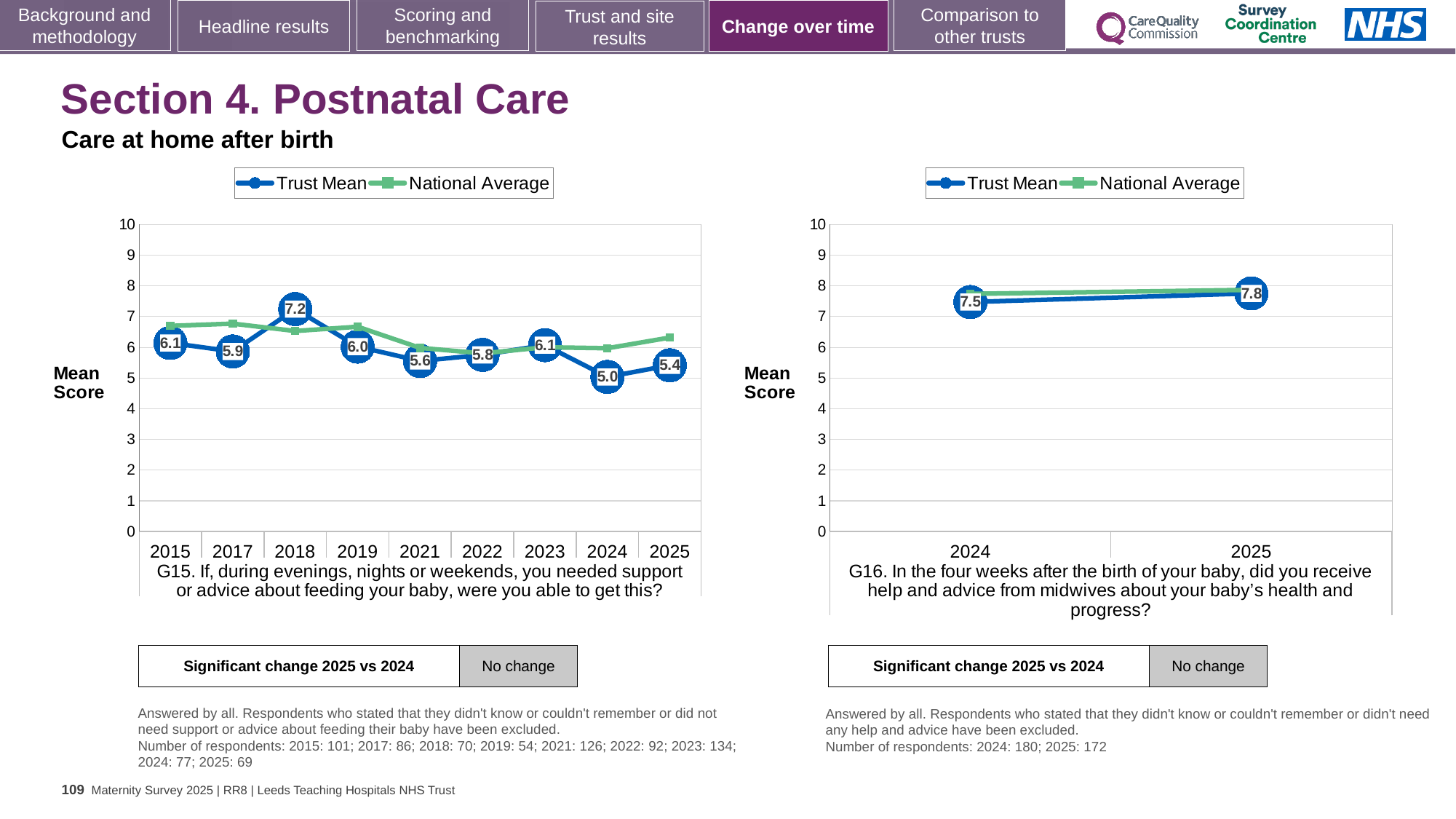
In the G15 chart on the left, which is larger, the Trust Mean for 2023 or the Trust Mean for 2025? 2023 How many years are shown on the x axis of the G15 chart on the left? 9 In the G15 chart on the left, what is the difference between the Trust Mean scores for 2018 and 2024? 2.2 In the G15 chart on the left, what is the Trust Mean score for 2018? 7.2 In the G15 chart on the left, what is the Trust Mean score for 2024? 5.0 In the G15 chart on the left, which year has the lowest Trust Mean score? 2024 In the G16 chart on the right, what is the difference between the Trust Mean scores for 2025 and 2024? 0.3 In the G15 chart on the left, which year has the highest Trust Mean score? 2018 How many series does the legend of the G16 chart on the right list? 2 What kind of chart is the G16 chart on the right? Line chart In the G15 chart on the left, is the National Average for 2025 greater or less than 6? greater In the G16 chart on the right, what is the Trust Mean score for 2025? 7.8